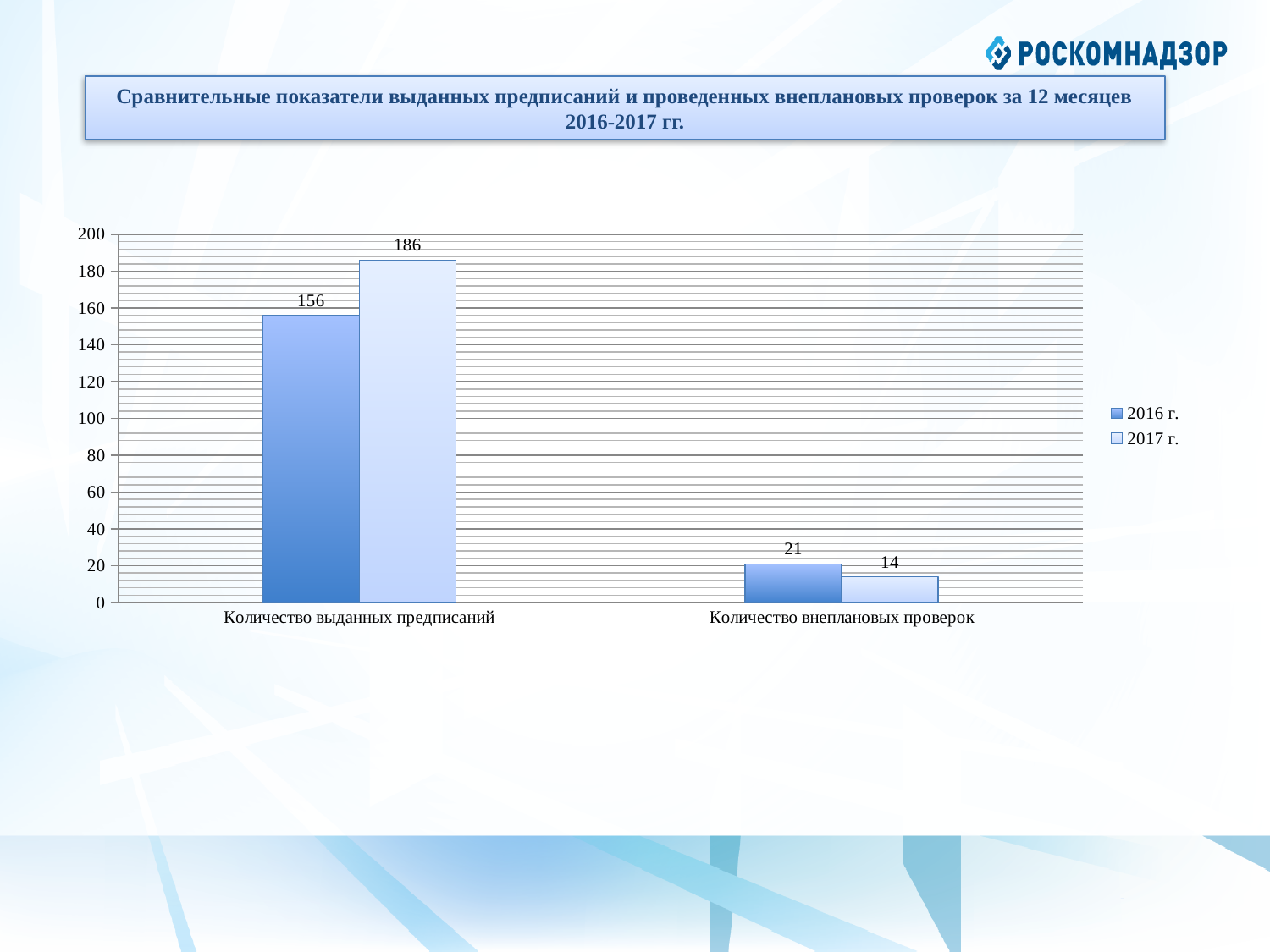
What is the value for 2016 г. in the category Количество выданных предписаний? 156 Which series has the higher value for Количество выданных предписаний, 2016 г. or 2017 г.? 2017 г. What is the value for 2016 г. in the category Количество внеплановых проверок? 21 Which series has the higher value for Количество внеплановых проверок, 2016 г. or 2017 г.? 2016 г. Which bar has the lowest value on the chart? 2017 г., Количество внеплановых проверок What is the value for 2017 г. in the category Количество выданных предписаний? 186 What is the difference between the 2017 г. and 2016 г. values for Количество выданных предписаний? 30 What is the difference between the 2016 г. and 2017 г. values for Количество внеплановых проверок? 7 Which bar has the highest value on the chart? 2017 г., Количество выданных предписаний What is the value for 2017 г. in the category Количество внеплановых проверок? 14 How many series does the legend list? 2 What kind of chart is shown on the slide? Bar chart